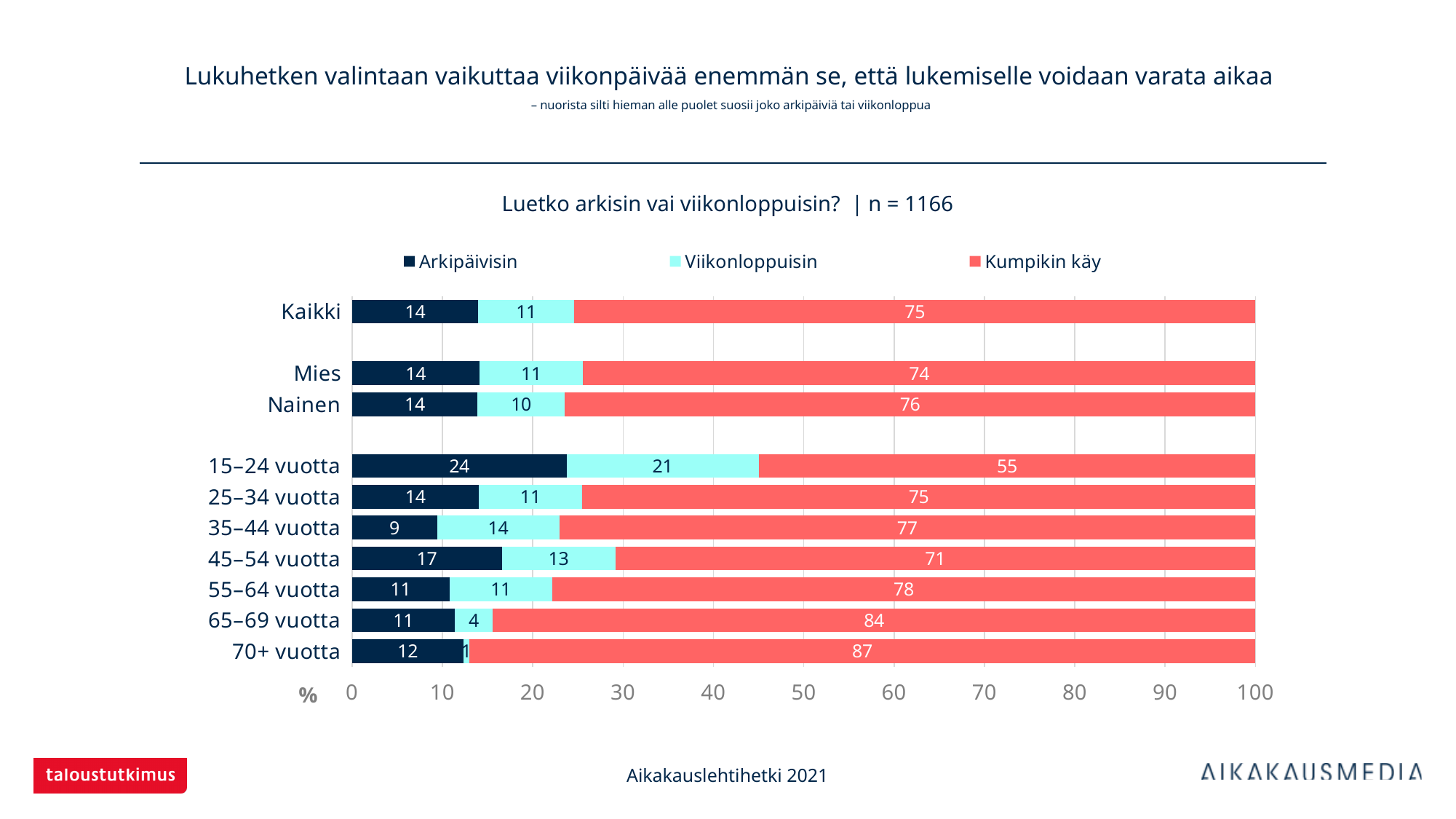
What is the Viikonloppuisin value for 65–69 vuotta? 4 What is the difference between the Kumpikin käy values for 70+ vuotta and 15–24 vuotta? 32 Which category has the highest Kumpikin käy value? 70+ vuotta What is the Arkipäivisin value for 15–24 vuotta? 24 How many series does the legend list? 3 What is the Kumpikin käy value for Kaikki? 75 Which is larger, the Arkipäivisin value for 45–54 vuotta or for 35–44 vuotta? 45–54 vuotta What is the sample size (n) stated in the chart title? 1166 Which category has the lowest Viikonloppuisin value? 70+ vuotta What kind of chart is shown on the slide? stacked bar chart What is the total of the stacked bar for Mies? 99 How many categories are plotted on the chart? 10